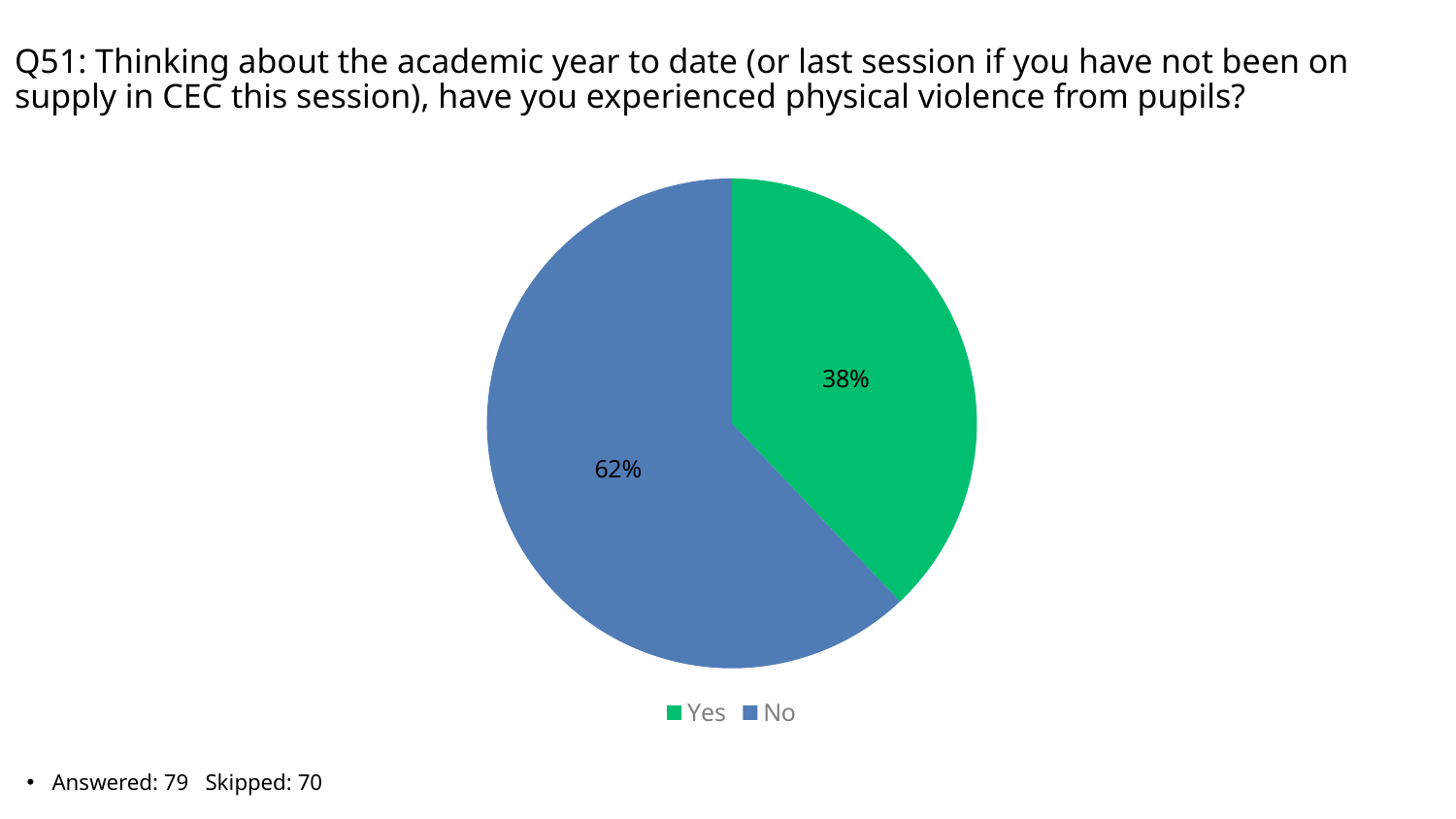
What kind of chart is shown on the slide? Pie chart How many entries does the legend list? 2 Which response has the largest share of the pie? No Which slice is larger, Yes or No? No What percentage of respondents answered Yes? 38% What is the difference in percentage points between the No and Yes slices? 24 What percentage of respondents answered No? 62% How many slices does the pie chart have? 2 What share of the pie does the Yes slice represent? 38% How many respondents answered the question according to the slide? 79 Which response has the smallest share of the pie? Yes What colour is the Yes slice? Green